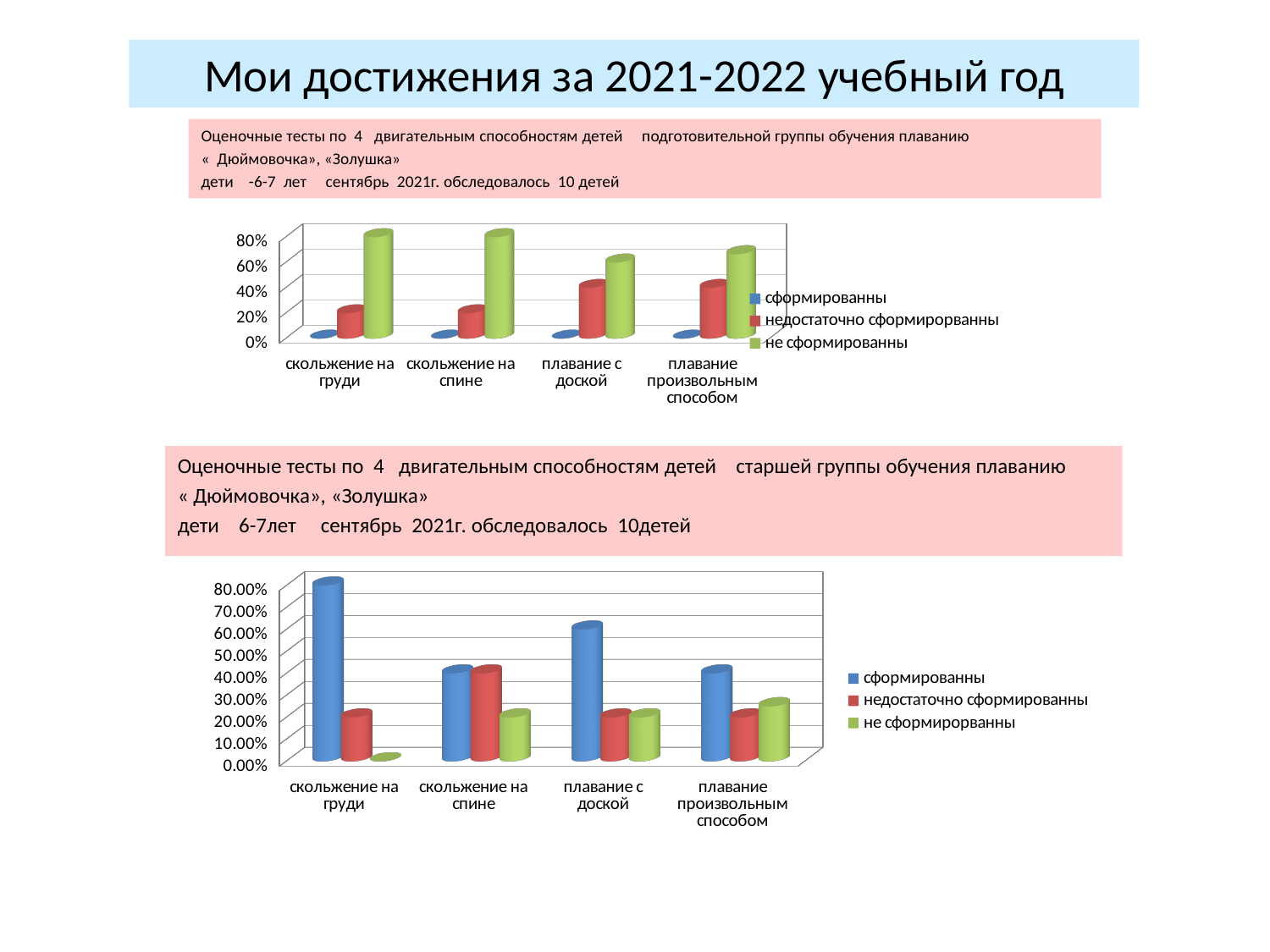
In the bottom chart, which category has the highest value for 'сформированны'? скольжение на груди In the top chart, is the value of 'не сформированны' for 'плавание с доской' greater or less than 40%? greater How many categories are shown on the x axis of the bottom chart? 4 What kind of chart is the top chart on the slide? bar chart What colour represents the 'сформированны' series in the bottom chart? blue In the bottom chart, is the value of 'не сформирорванны' for 'плавание произвольным способом' greater or less than 40.00%? less In the top chart, is the value of 'недостаточно сформирорванны' for 'скольжение на спине' greater or less than 40%? less In the bottom chart, which is larger for 'плавание с доской': 'сформированны' or 'недостаточно сформированны'? сформированны In the top chart, which series has the tallest bar for 'скольжение на груди'? не сформированны In the bottom chart, which category has the lowest value for 'не сформирорванны'? скольжение на груди How many series does the legend of the top chart list? 3